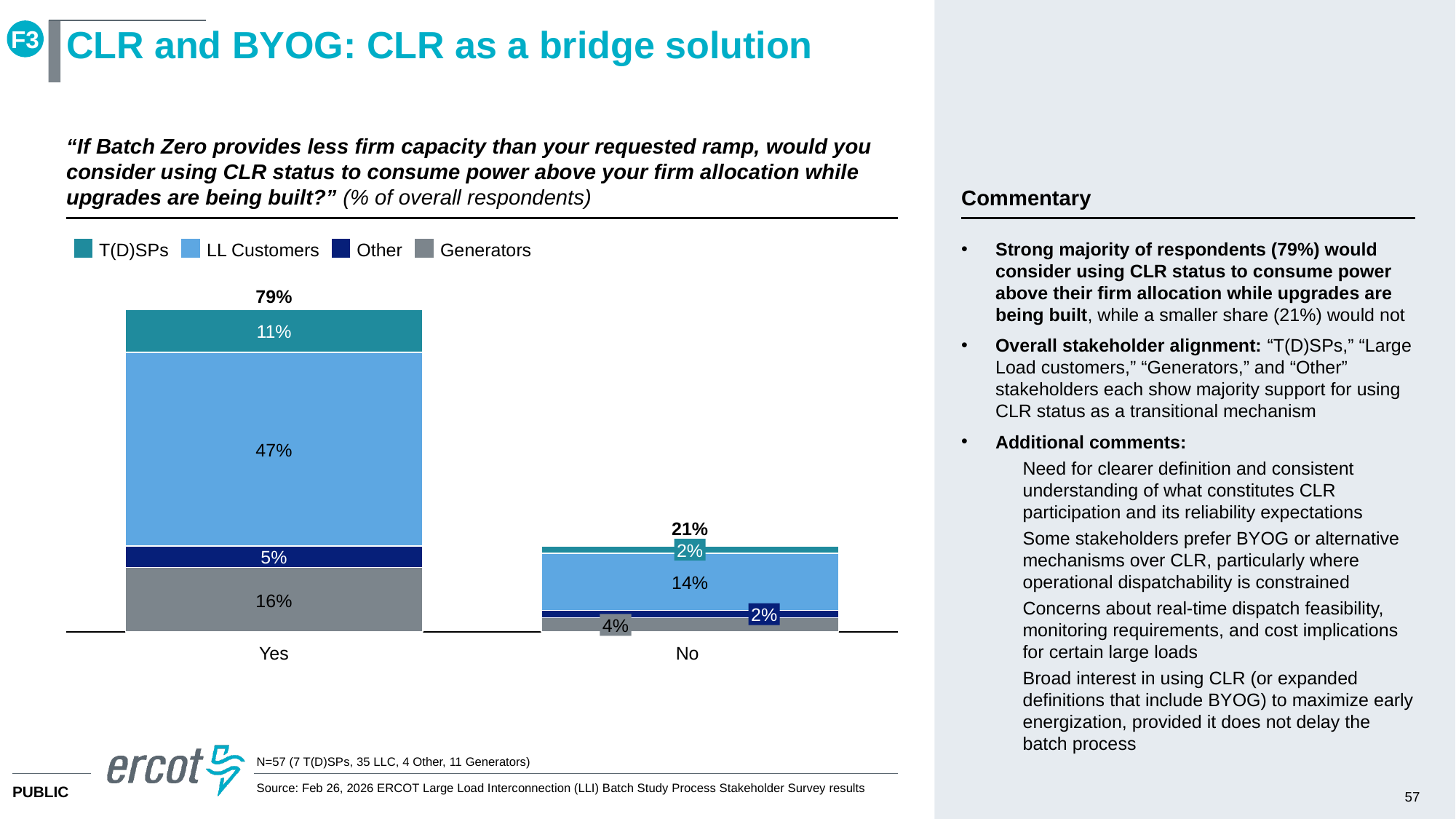
What is the Other value in the No bar? 2% How many series does the legend list? 4 Which series is shown in grey in the legend? Generators What is the difference between the Generators values for Yes and No? 12% What kind of chart is shown? Stacked bar chart What is the Generators value in the No bar? 4% What is the T(D)SPs value in the Yes bar? 11% What is the total for the Yes bar? 79% What is the total for the No bar? 21% How many categories are shown on the x axis? 2 Which category has the higher total, Yes or No? Yes What is the LL Customers value in the Yes bar? 47%